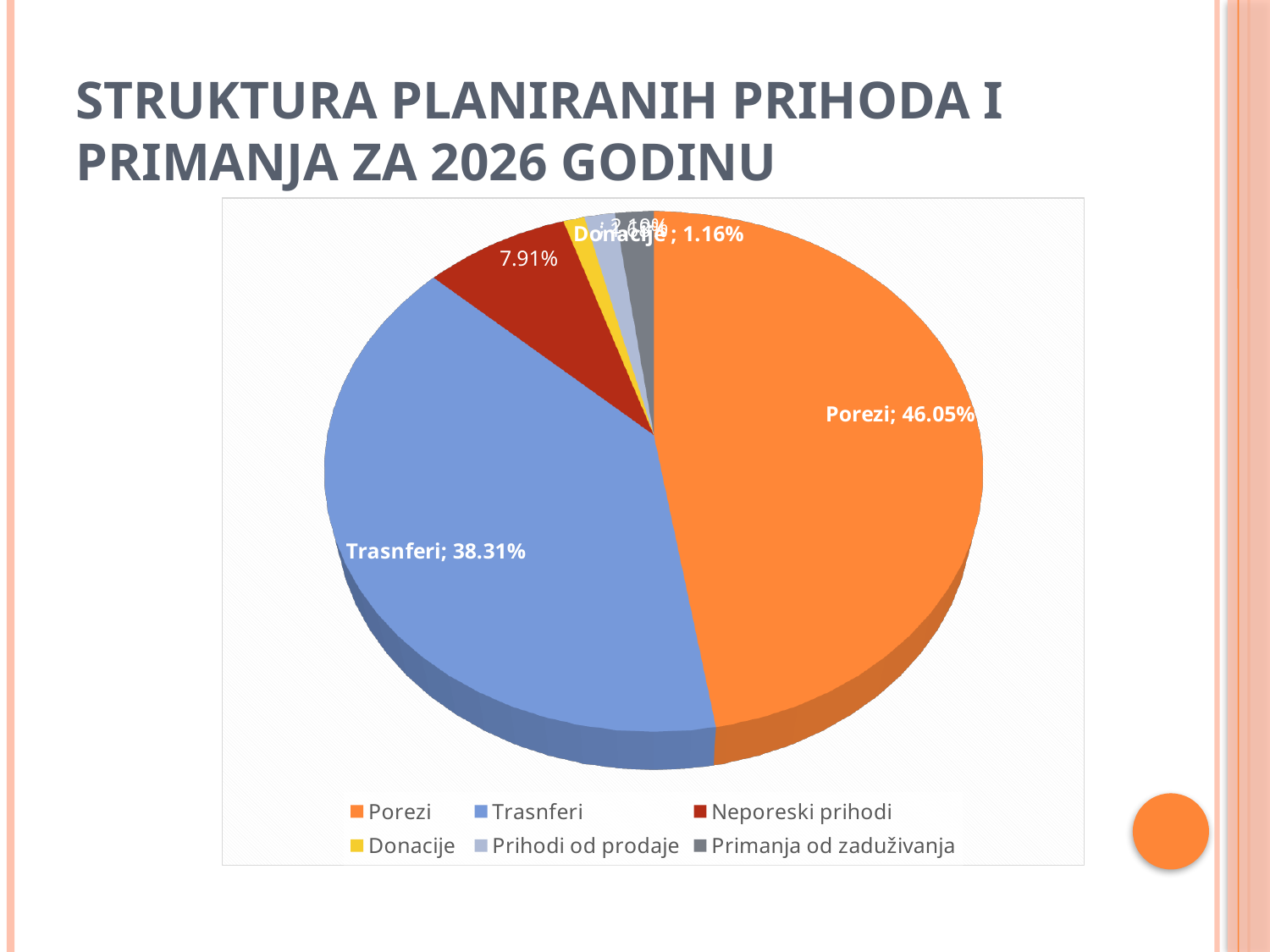
What kind of chart is shown on the slide? pie chart What share of the pie does Porezi have? 46.05% What share of the pie does Trasnferi have? 38.31% Which is larger, the slice for Porezi or the slice for Trasnferi? Porezi What is the combined share of Porezi and Trasnferi? 84.36% Which category has the largest slice of the pie? Porezi What colour is the Porezi slice? orange Which is larger, the slice for Trasnferi or the slice for Neporeski prihodi? Trasnferi What is the difference in percentage points between the Porezi share and the Trasnferi share? 7.74 What share of the pie does Donacije have? 1.16% How many categories does the legend list? 6 What share of the pie does Neporeski prihodi have? 7.91%